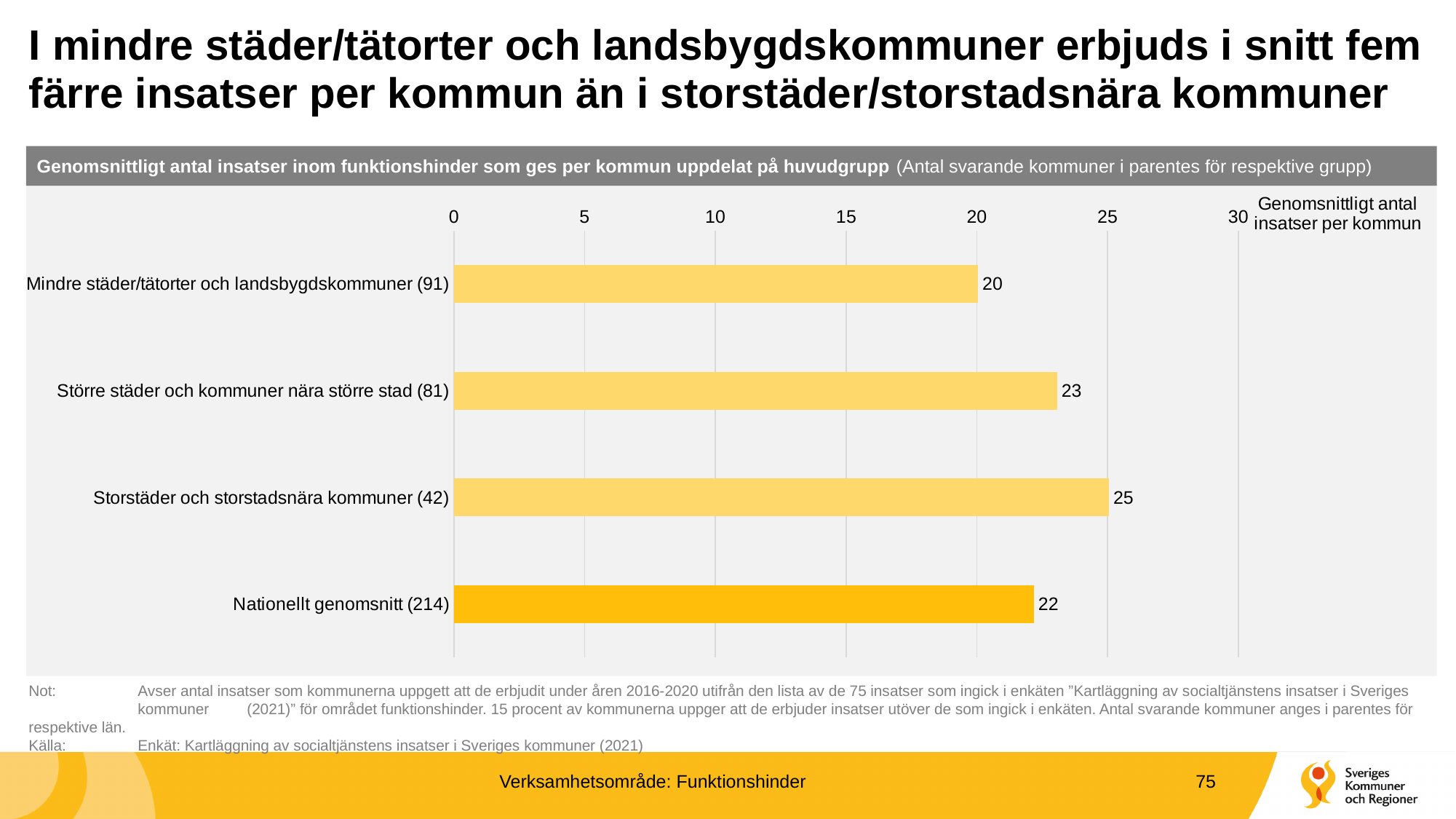
Is the value for Storstäder och storstadsnära kommuner (42) greater or less than 30? less What is the value shown for Nationellt genomsnitt (214)? 22 How many categories are shown in the chart? 4 Which category has the highest average number of insatser per kommun? Storstäder och storstadsnära kommuner (42) What is the average number of insatser per kommun for Större städer och kommuner nära större stad (81)? 23 Which category has the lowest average number of insatser per kommun? Mindre städer/tätorter och landsbygdskommuner (91) What is the average number of insatser per kommun for Storstäder och storstadsnära kommuner (42)? 25 What is the average number of insatser per kommun for Mindre städer/tätorter och landsbygdskommuner (91)? 20 Which is larger: the value for Större städer och kommuner nära större stad (81) or the value for Nationellt genomsnitt (214)? Större städer och kommuner nära större stad (81) What is the difference between the values for Storstäder och storstadsnära kommuner (42) and Mindre städer/tätorter och landsbygdskommuner (91)? 5 What is the label of the horizontal axis of the chart? Genomsnittligt antal insatser per kommun What kind of chart is shown on the slide? bar chart